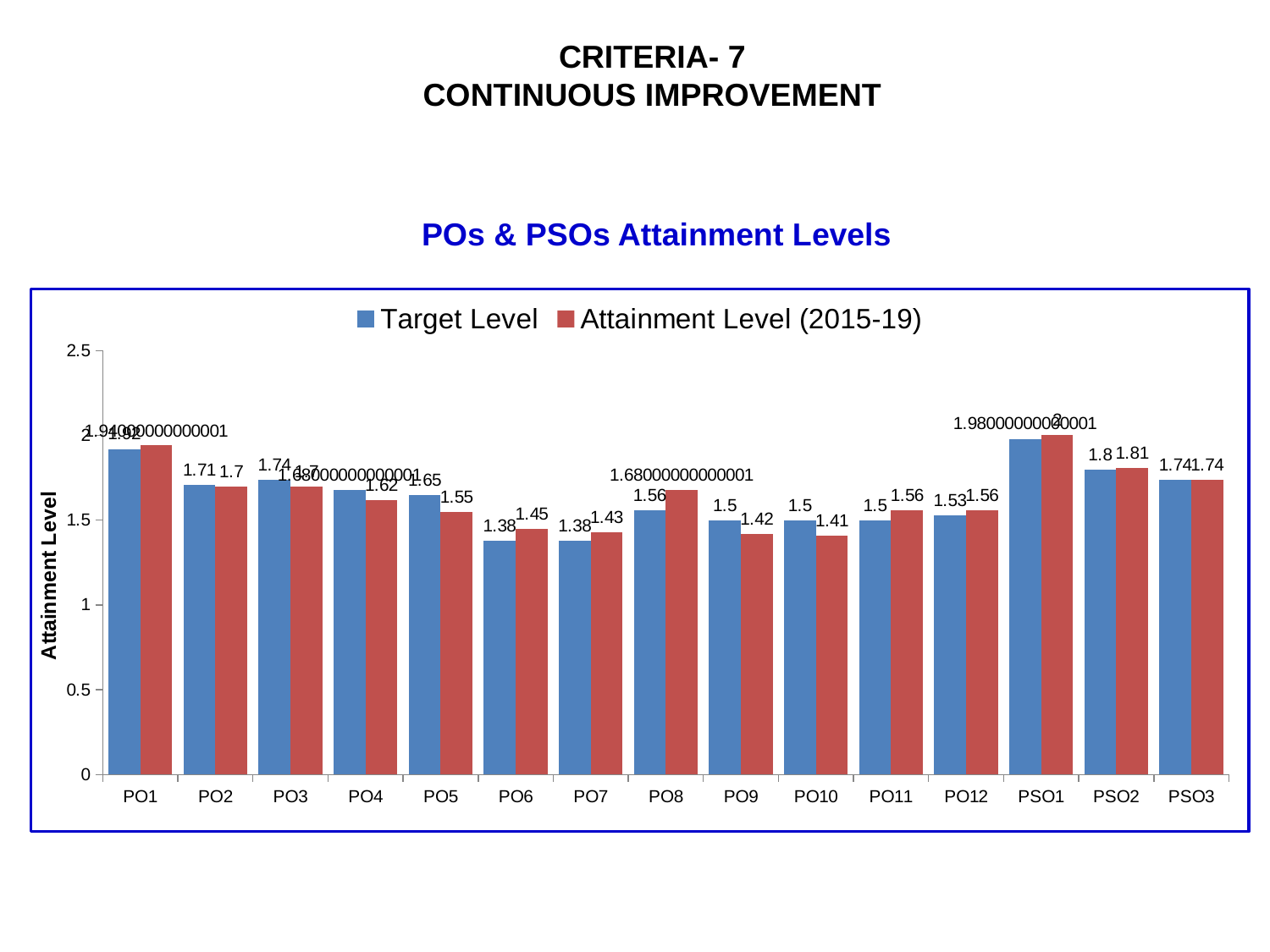
How many series does the legend list? 2 Which category has the highest Attainment Level (2015-19)? PSO1 What is the Target Level for PO9? 1.5 What is the title of the y axis? Attainment Level What is the difference between the Target Level and the Attainment Level (2015-19) for PO5? 0.1 For PO6, which is larger: the Target Level or the Attainment Level (2015-19)? Attainment Level (2015-19) Is the Attainment Level (2015-19) for PO8 greater or less than 1.5? greater How many categories are shown on the x axis? 15 What is the Attainment Level (2015-19) for PO6? 1.45 What is the Target Level for PO5? 1.65 What kind of chart is shown on the slide? bar chart What is the Attainment Level (2015-19) for PSO2? 1.81